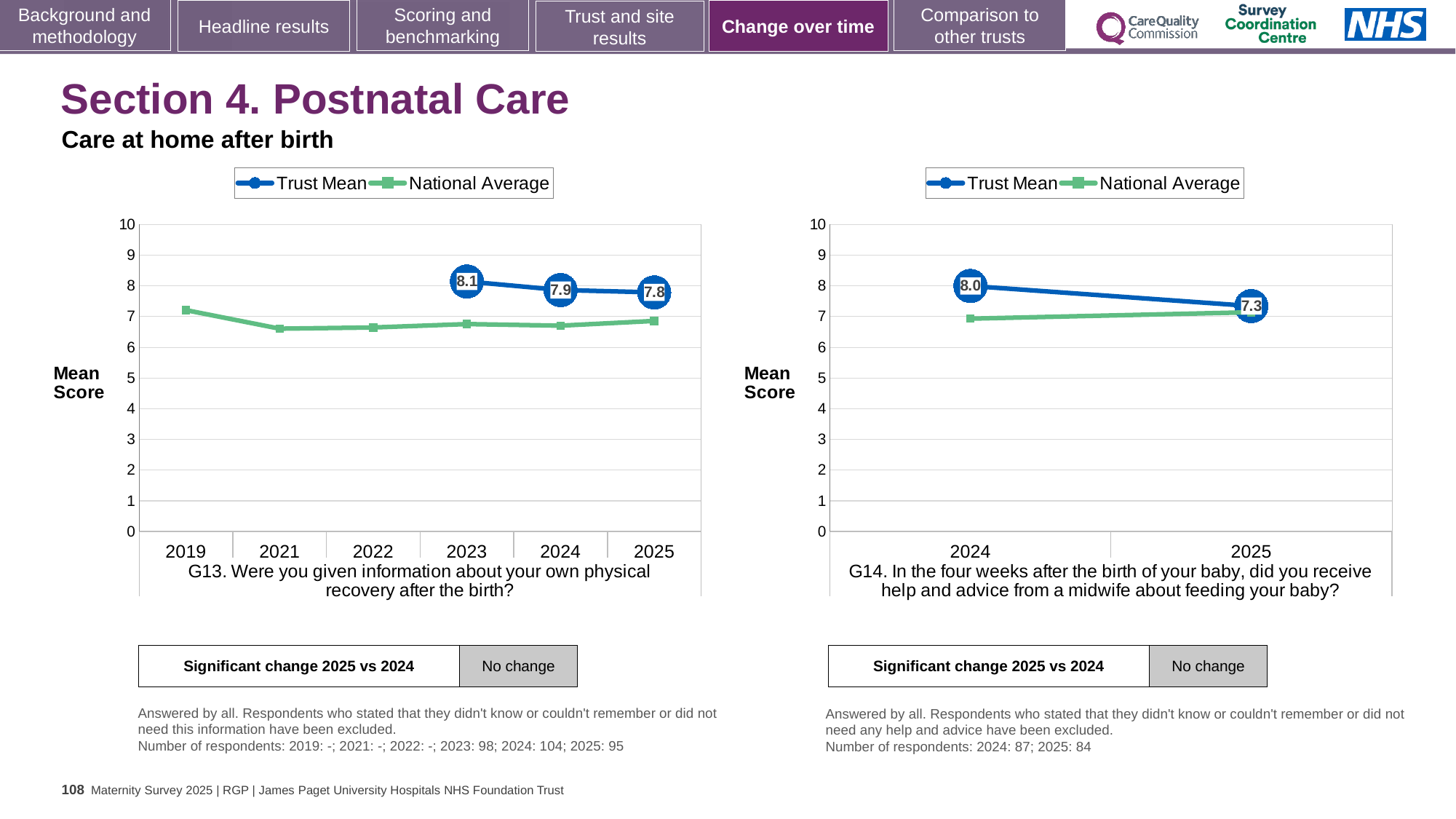
In the G14 chart on the right, what is the Trust Mean for 2025? 7.3 In the G13 chart on the left, is the National Average for 2021 greater or less than 7? less In the G13 chart on the left, what is the Trust Mean for 2025? 7.8 What type of chart is the G14 chart on the right? Line chart In the G14 chart on the right, what is the Trust Mean for 2024? 8.0 In the G13 chart on the left, which year has the highest Trust Mean? 2023 In the G14 chart on the right, does the Trust Mean rise or fall from 2024 to 2025? Fall In the G13 chart on the left, what is the Trust Mean for 2023? 8.1 In the G14 chart on the right, how many series does the legend list? 2 In the G13 chart on the left, how many years are shown on the x axis? 6 In the G13 chart on the left, what is the difference between the Trust Mean in 2023 and in 2025? 0.3 In the G14 chart on the right, by how much did the Trust Mean fall from 2024 to 2025? 0.7